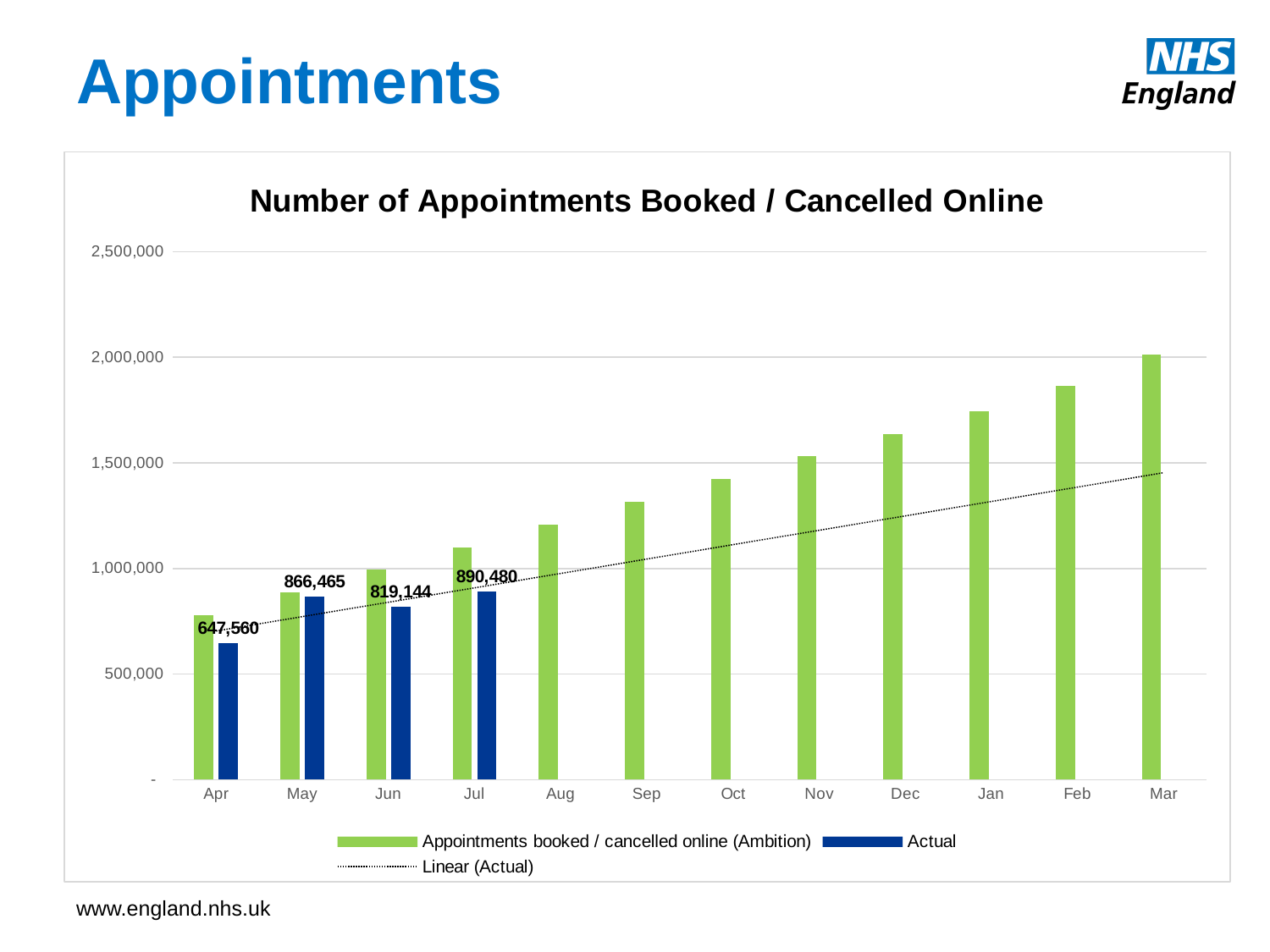
What is the Actual value for May? 866,465 Which month has the lowest Actual value? Apr Which month has the highest Actual value? Jul How many entries does the legend list? 3 What is the Actual value for Jun? 819,144 What is the difference between the Actual values for Jul and Apr? 242,920 Is the Ambition value for Aug greater or less than 1,000,000? greater Which is larger, the Actual value for May or for Jun? May How many months are shown on the x axis? 12 Do the Ambition values rise or fall from Apr to Mar? rise What is the Actual value for Apr? 647,560 What is the Actual value for Jul? 890,480